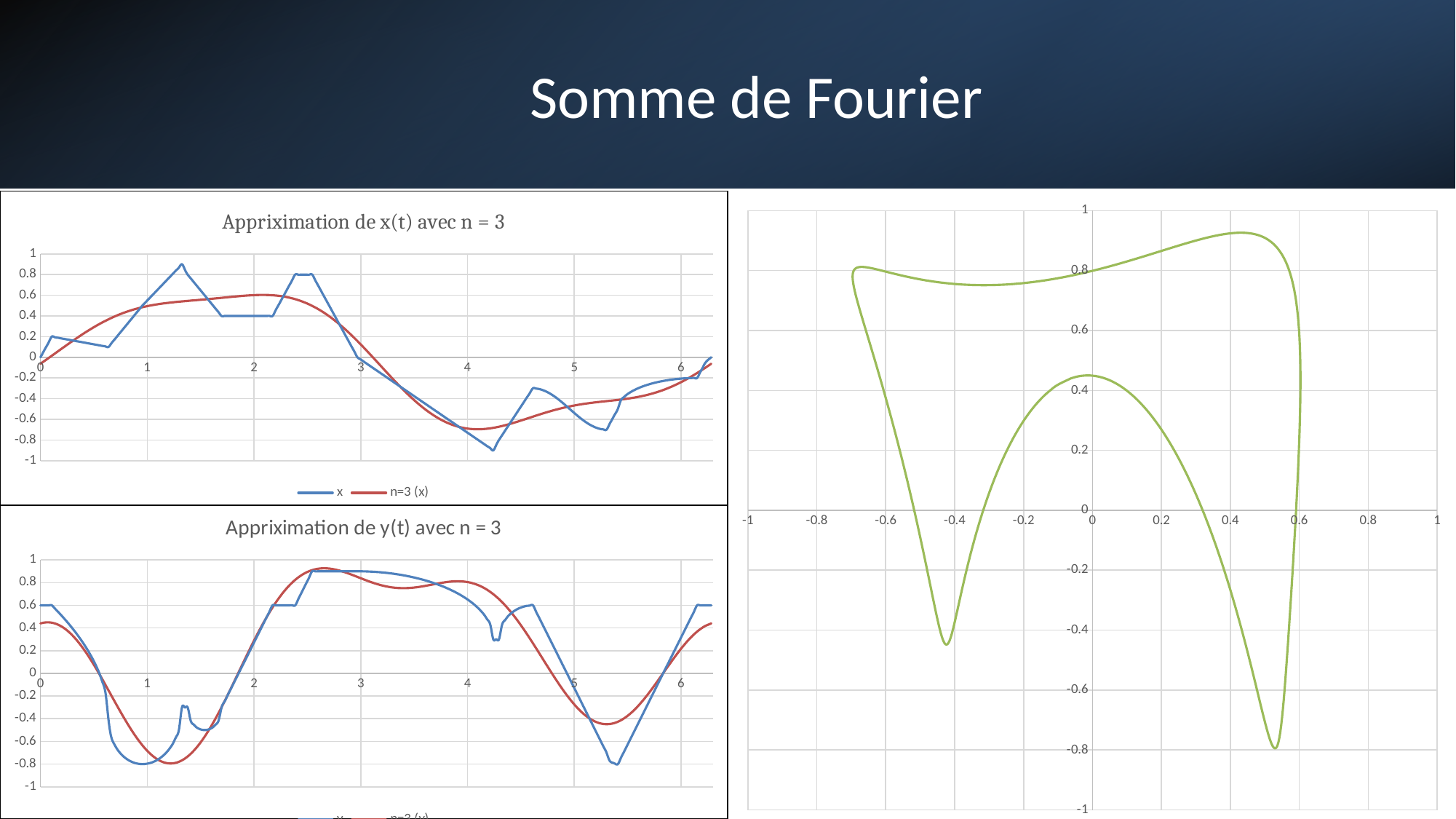
How many series does the legend of the top-left chart "Appriximation de x(t) avec n = 3" list? 2 In the top-left chart "Appriximation de x(t) avec n = 3", is the highest value of the blue x series greater or less than 0.6? greater What kind of chart is the top-left chart titled "Appriximation de x(t) avec n = 3"? line chart In the bottom-left chart "Appriximation de y(t) avec n = 3", is the lowest value of the blue series greater or less than -0.6? less In the top-left chart "Appriximation de x(t) avec n = 3", does the red n=3 (x) curve rise or fall between t = 3 and t = 4? fall In the top-left chart "Appriximation de x(t) avec n = 3", is the highest value of the red n=3 (x) curve greater or less than 0.8? less What is the title of the bottom-left chart? Appriximation de y(t) avec n = 3 In the bottom-left chart "Appriximation de y(t) avec n = 3", does the blue series rise or fall between t = 1 and t = 2.5? rise What are the two legend entries of the top-left chart "Appriximation de x(t) avec n = 3"? x and n=3 (x)